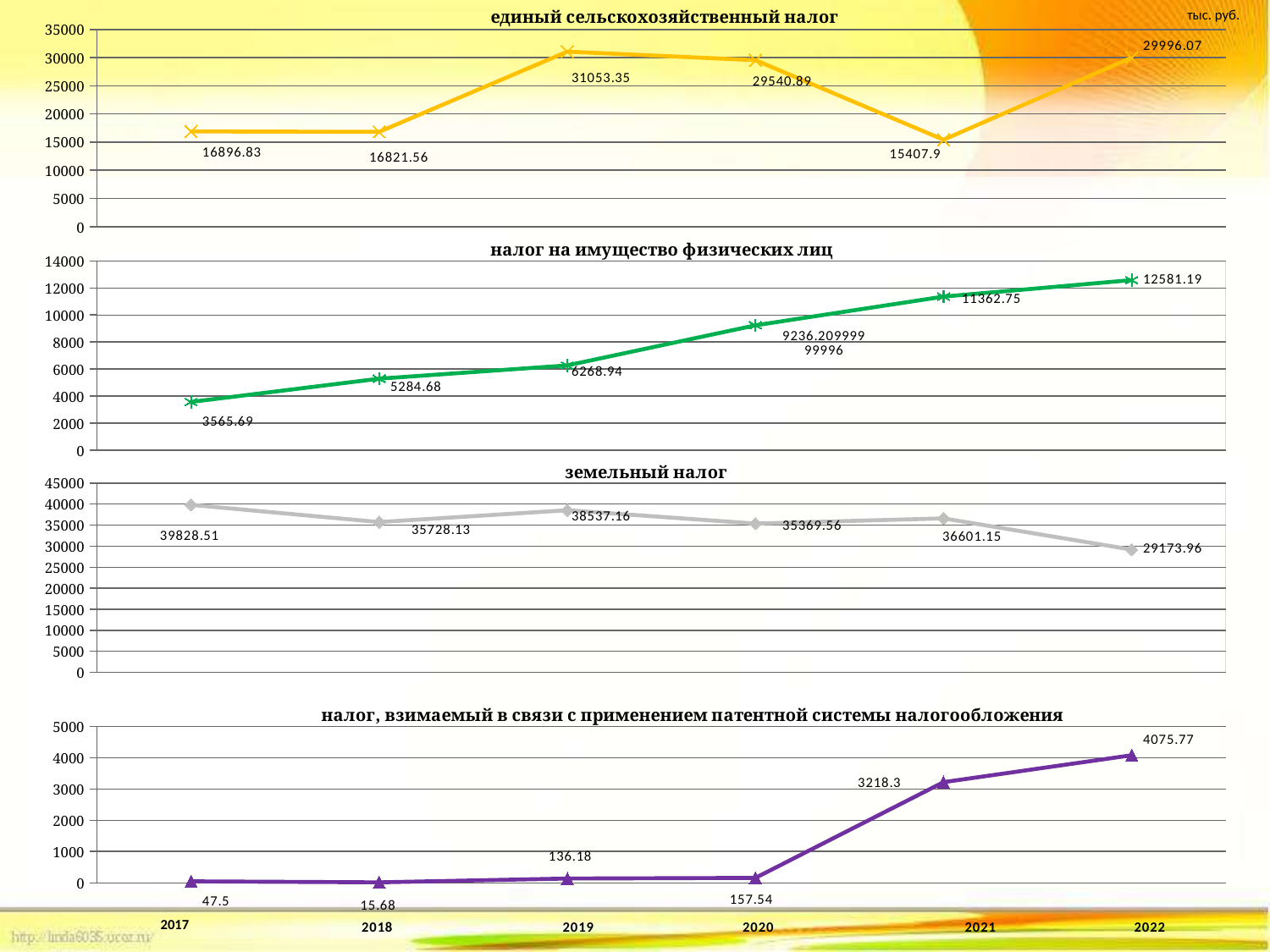
What type of chart is the chart titled 'земельный налог'? line chart In the chart titled 'земельный налог', what is the value for 2018? 35728.13 In the chart titled 'налог на имущество физических лиц', which year has the lowest value? 2017 In the chart titled 'земельный налог', what is the difference between the 2017 and 2022 values? 10654.55 In the chart titled 'налог на имущество физических лиц', do the values rise or fall from 2017 to 2022? rise In the chart titled 'единый сельскохозяйственный налог', what is the value for 2019? 31053.35 In the chart titled 'единый сельскохозяйственный налог', which year has the lowest value? 2021 In the chart titled 'земельный налог', which year has the highest value? 2017 In the chart titled 'единый сельскохозяйственный налог', what is the difference between the 2019 and 2020 values? 1512.46 In the chart titled 'налог на имущество физических лиц', what is the value for 2022? 12581.19 In the chart titled 'налог, взимаемый в связи с применением патентной системы налогообложения', which is larger, the value for 2019 or the value for 2020? 2020 In the chart titled 'налог, взимаемый в связи с применением патентной системы налогообложения', what is the value for 2021? 3218.3